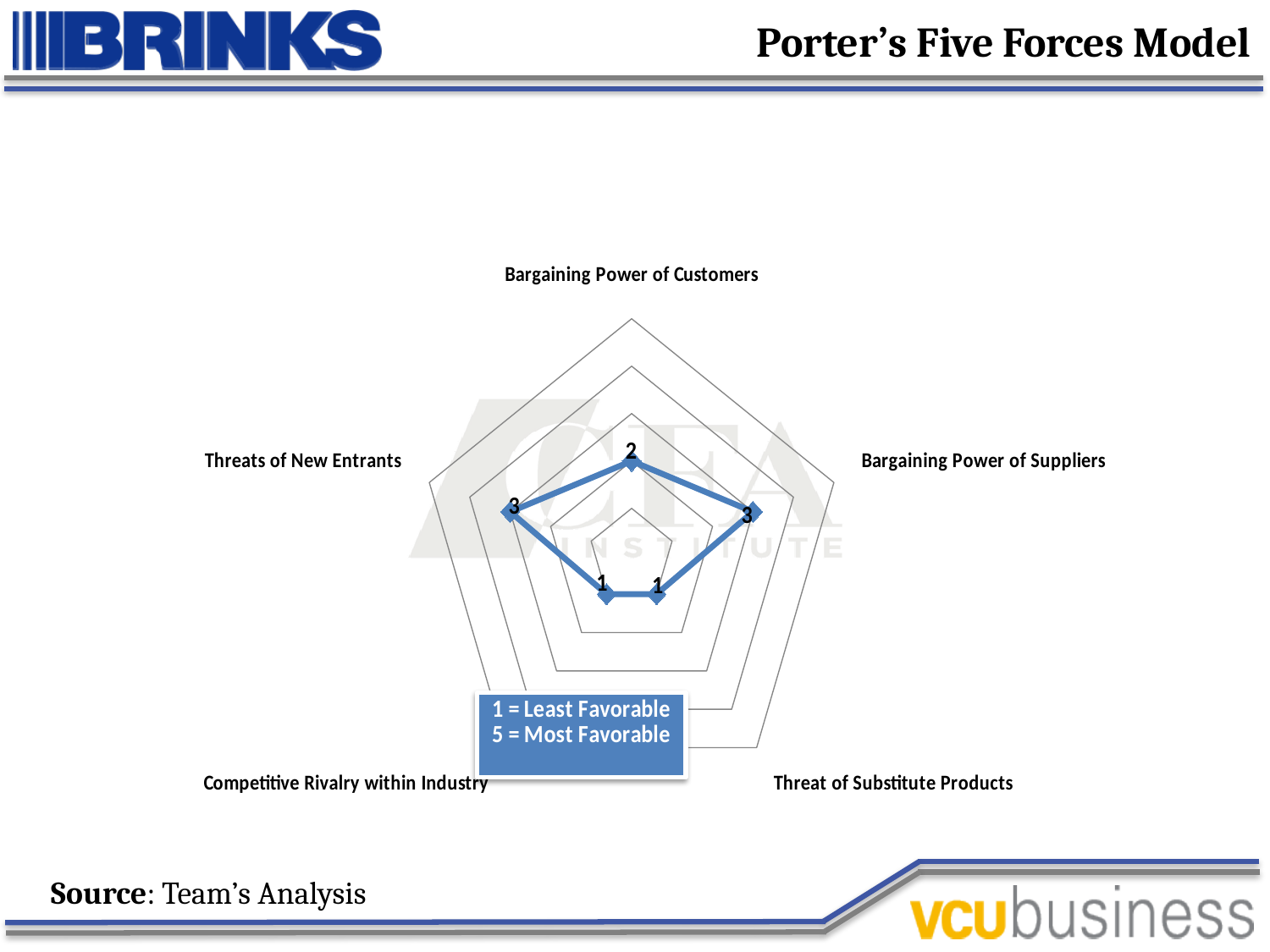
What is the title of the slide containing the chart? Porter's Five Forces Model What kind of chart is shown on the slide? Radar chart What is the value for Threat of Substitute Products? 1 What is the value for Threats of New Entrants? 3 How many forces (categories) are plotted on the radar chart? 5 Which is larger, the value for Bargaining Power of Suppliers or the value for Bargaining Power of Customers? Bargaining Power of Suppliers What is the value for Competitive Rivalry within Industry? 1 What is the difference between the value for Threats of New Entrants and the value for Competitive Rivalry within Industry? 2 Which categories have the lowest value on the chart? Threat of Substitute Products and Competitive Rivalry within Industry What is the value for Bargaining Power of Customers? 2 What is the value for Bargaining Power of Suppliers? 3 According to the legend box, what does a score of 5 represent? Most Favorable